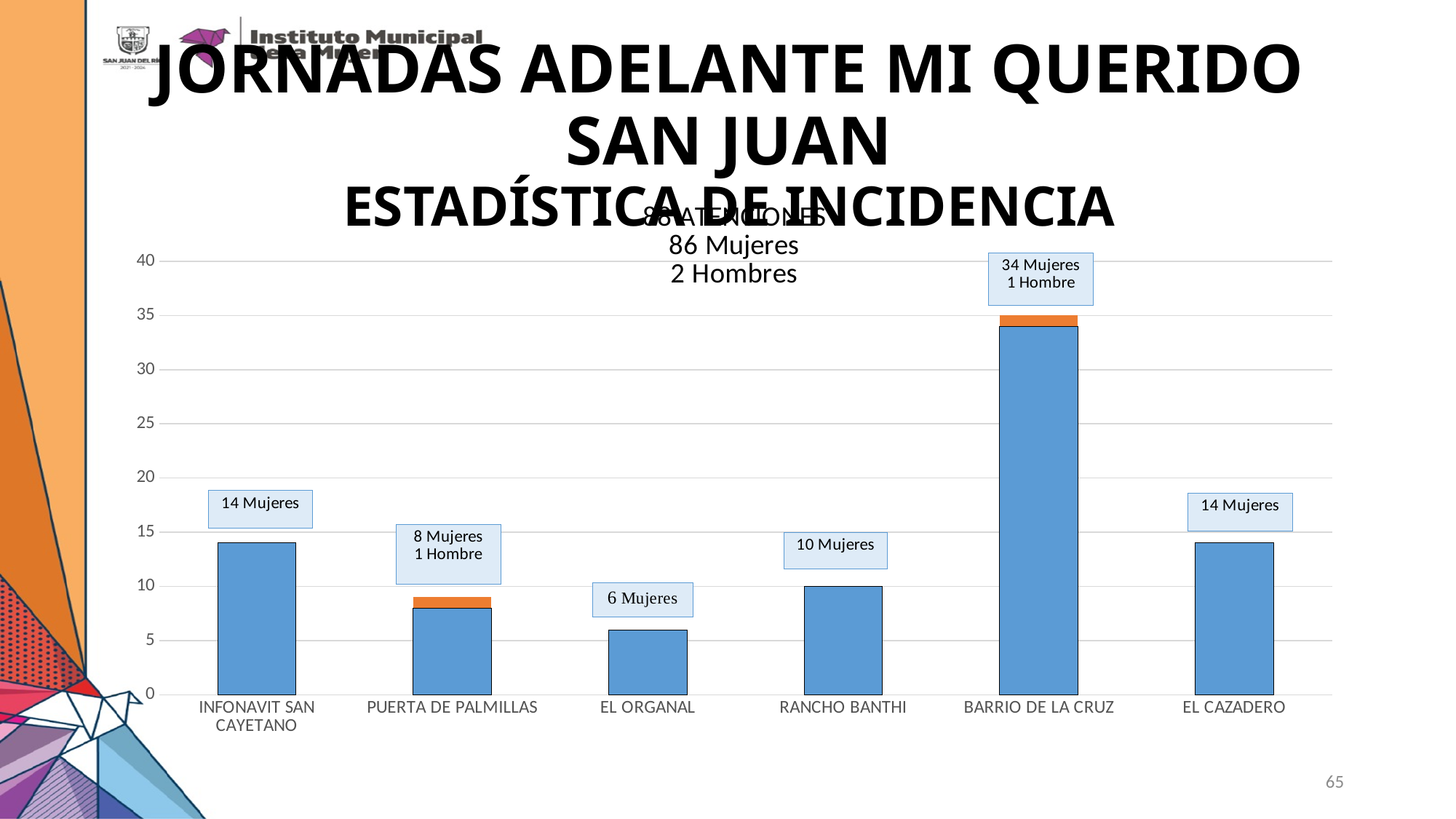
What kind of chart is shown on the slide? Bar chart What is the total height of the stacked bar for BARRIO DE LA CRUZ (Mujeres plus Hombre)? 35 How many men (Hombres) are recorded for PUERTA DE PALMILLAS? 1 Which has more women, RANCHO BANTHI or INFONAVIT SAN CAYETANO? INFONAVIT SAN CAYETANO Which location has the lowest bar? EL ORGANAL How many locations are shown on the x axis of the chart? 6 How many women (Mujeres) are recorded for EL ORGANAL? 6 How many women (Mujeres) are recorded for BARRIO DE LA CRUZ? 34 What is the total height of the stacked bar for PUERTA DE PALMILLAS (Mujeres plus Hombre)? 9 What is the difference between the number of women at BARRIO DE LA CRUZ and at EL CAZADERO? 20 Which location has the highest bar? BARRIO DE LA CRUZ How many women (Mujeres) are recorded for RANCHO BANTHI? 10